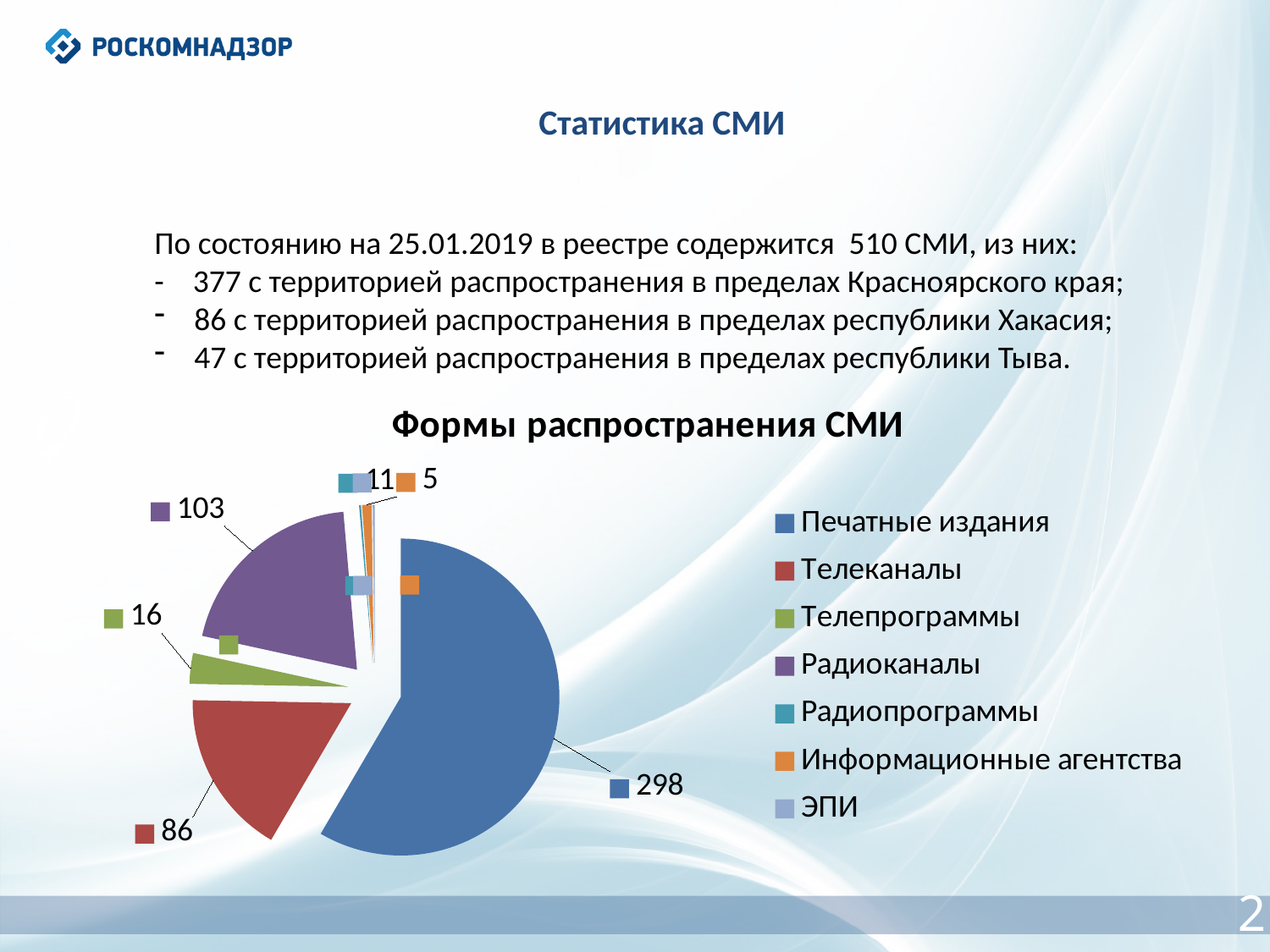
In the pie chart "Формы распространения СМИ", what is the value for Печатные издания? 298 In the pie chart "Формы распространения СМИ", what is the value for Радиопрограммы? 1 In the pie chart "Формы распространения СМИ", which is larger: Радиоканалы or Телеканалы? Радиоканалы In the pie chart "Формы распространения СМИ", what colour is the slice for Телепрограммы? green What kind of chart is shown under the title "Формы распространения СМИ"? pie chart In the pie chart "Формы распространения СМИ", what is the value for Информационные агентства? 5 In the pie chart "Формы распространения СМИ", what is the value for Телеканалы? 86 In the pie chart "Формы распространения СМИ", which category has the largest slice? Печатные издания In the pie chart "Формы распространения СМИ", what is the value for Телепрограммы? 16 In the pie chart "Формы распространения СМИ", what is the value for Радиоканалы? 103 How many categories does the legend of the pie chart "Формы распространения СМИ" list? 7 In the pie chart "Формы распространения СМИ", what is the difference between Печатные издания and Радиоканалы? 195